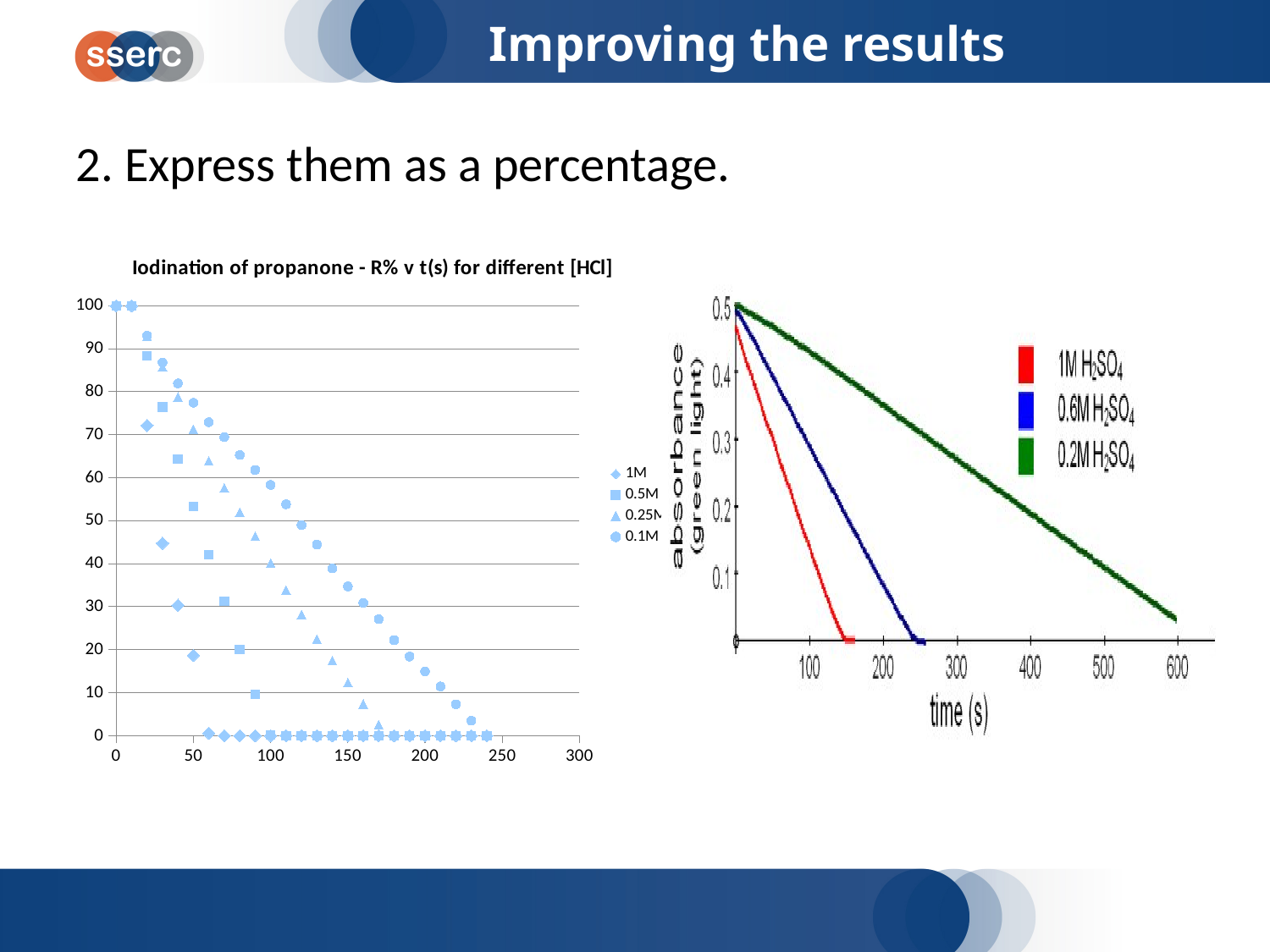
In the left chart, is the value for the 0.1M series at 150 s greater or less than 40? less In the right chart (absorbance v time), which series takes the longest time to reach zero absorbance? 0.2M H2SO4 What is the title of the chart on the left of the slide? Iodination of propanone - R% v t(s) for different [HCl] How many series does the legend of the right chart (absorbance v time) list? 3 In the left chart, is the value for the 1M series at 30 s greater or less than 40? greater In the left chart, at 100 s, which series has the larger R% value, 0.1M or 0.25M? 0.1M What kind of chart is the left chart (Iodination of propanone)? scatter chart How many series does the legend of the left chart list? 4 In the left chart, do the R% values rise or fall as time increases? fall In the left chart, what is the R% value of the series at time 0? 100 In the left chart, at 50 s, which series has the larger R% value, 0.5M or 1M? 0.5M